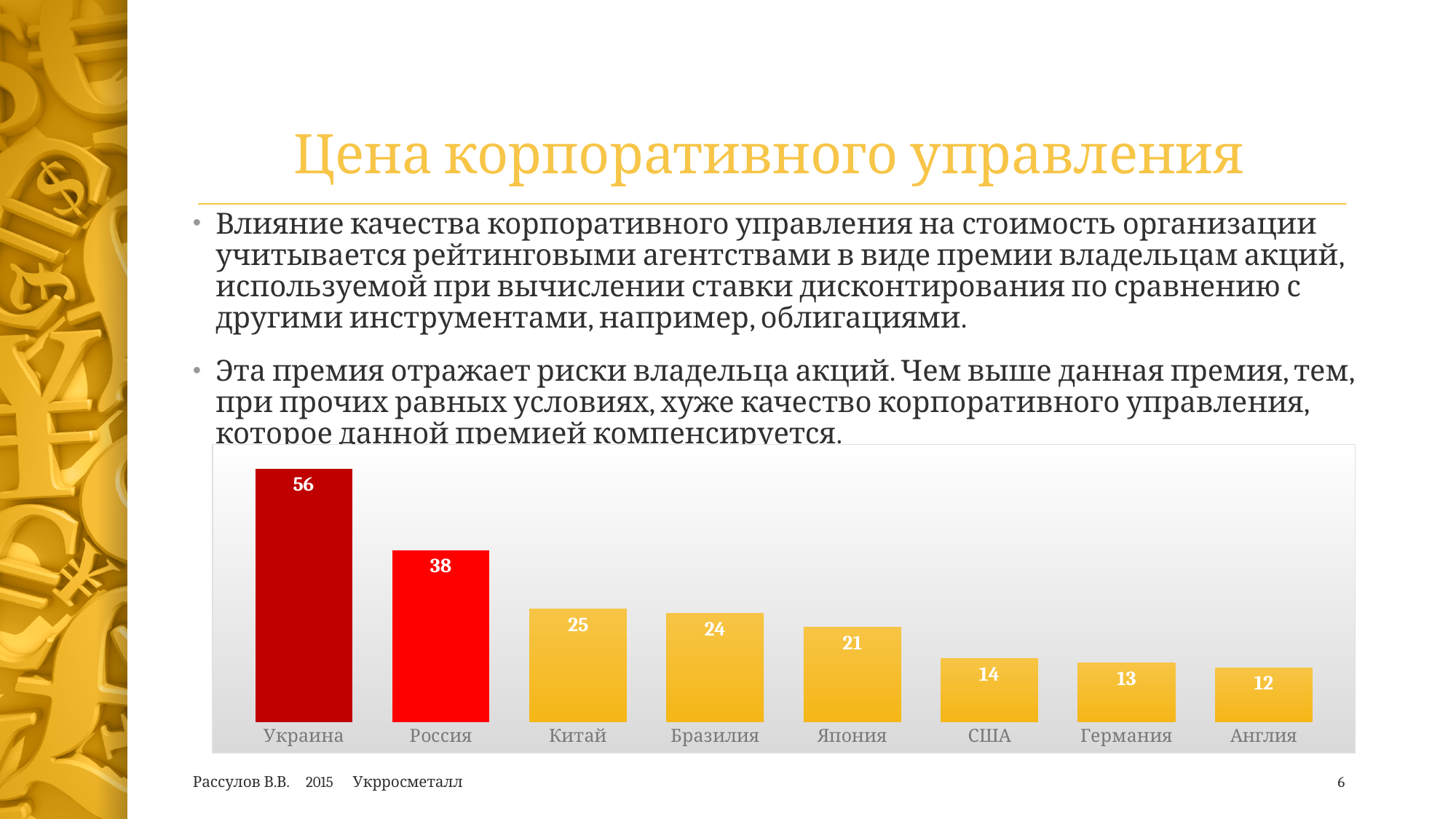
What is the value for Украина? 56 Which is larger, the value for Бразилия or the value for Япония? Бразилия What kind of chart is shown on the slide? Bar chart What is the value for Россия? 38 What is the difference between the values for Украина and Россия? 18 Which category has the lowest value? Англия What is the difference between the values for Китай and США? 11 Which category has the highest value? Украина What is the value for Германия? 13 Do the values rise or fall from left to right along the x axis? Fall What is the value for Япония? 21 How many categories are shown in the chart? 8